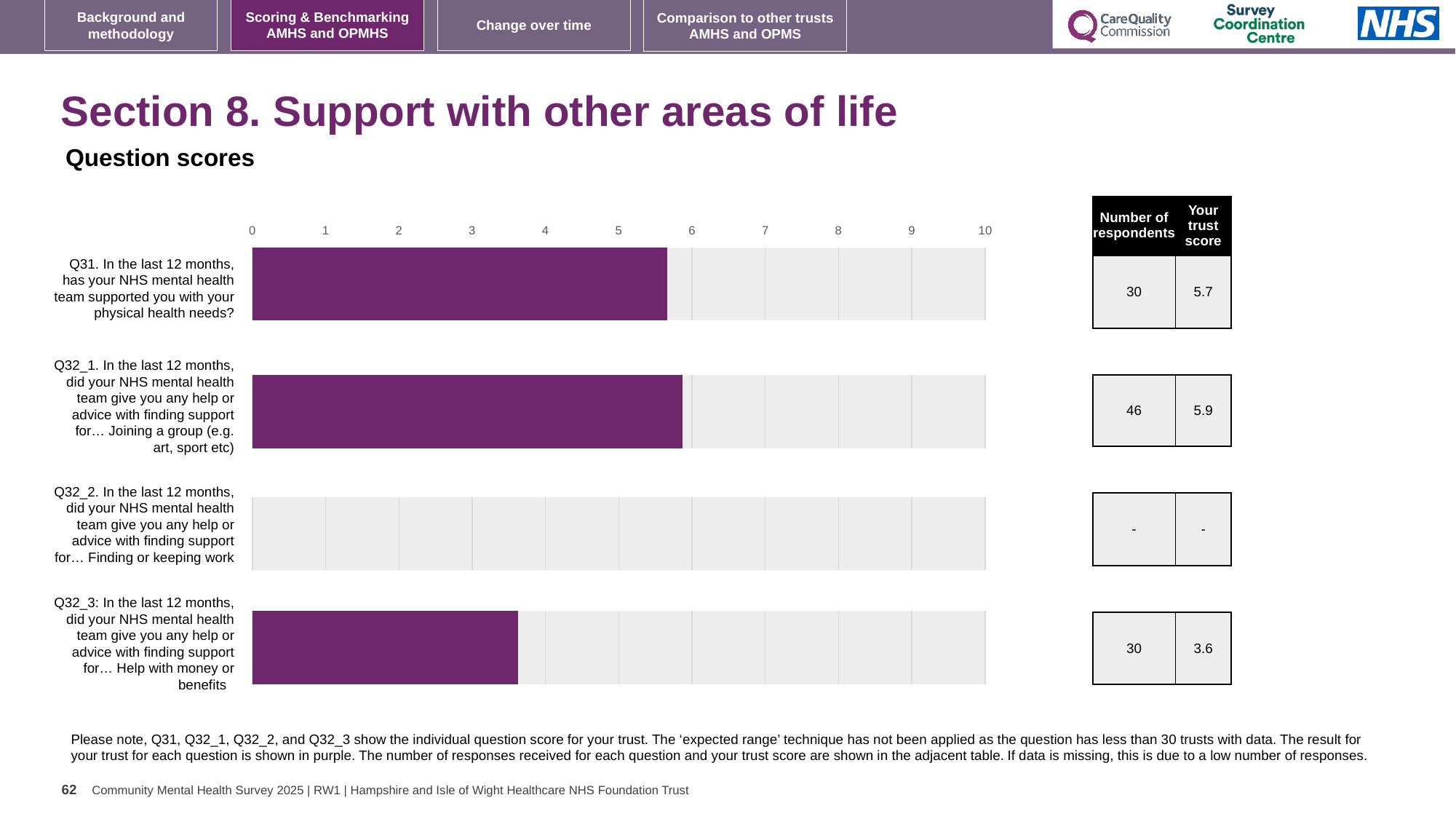
Which question has the highest trust score? Q32_1 Which has a higher trust score, Q31 or Q32_3? Q31 What is the trust score for Q32_3 (help with money or benefits)? 3.6 Which question with a plotted bar has the lowest trust score? Q32_3 How many respondents answered Q32_1? 46 What is the trust score for Q31 (supported you with your physical health needs)? 5.7 How many questions are listed on the chart? 4 Is the trust score for Q32_3 greater or less than 4? less How many respondents answered Q31? 30 What is the trust score for Q32_1 (help or advice with finding support for joining a group)? 5.9 What type of chart is shown on the slide? Bar chart What is the difference between the trust scores for Q32_1 and Q32_3? 2.3